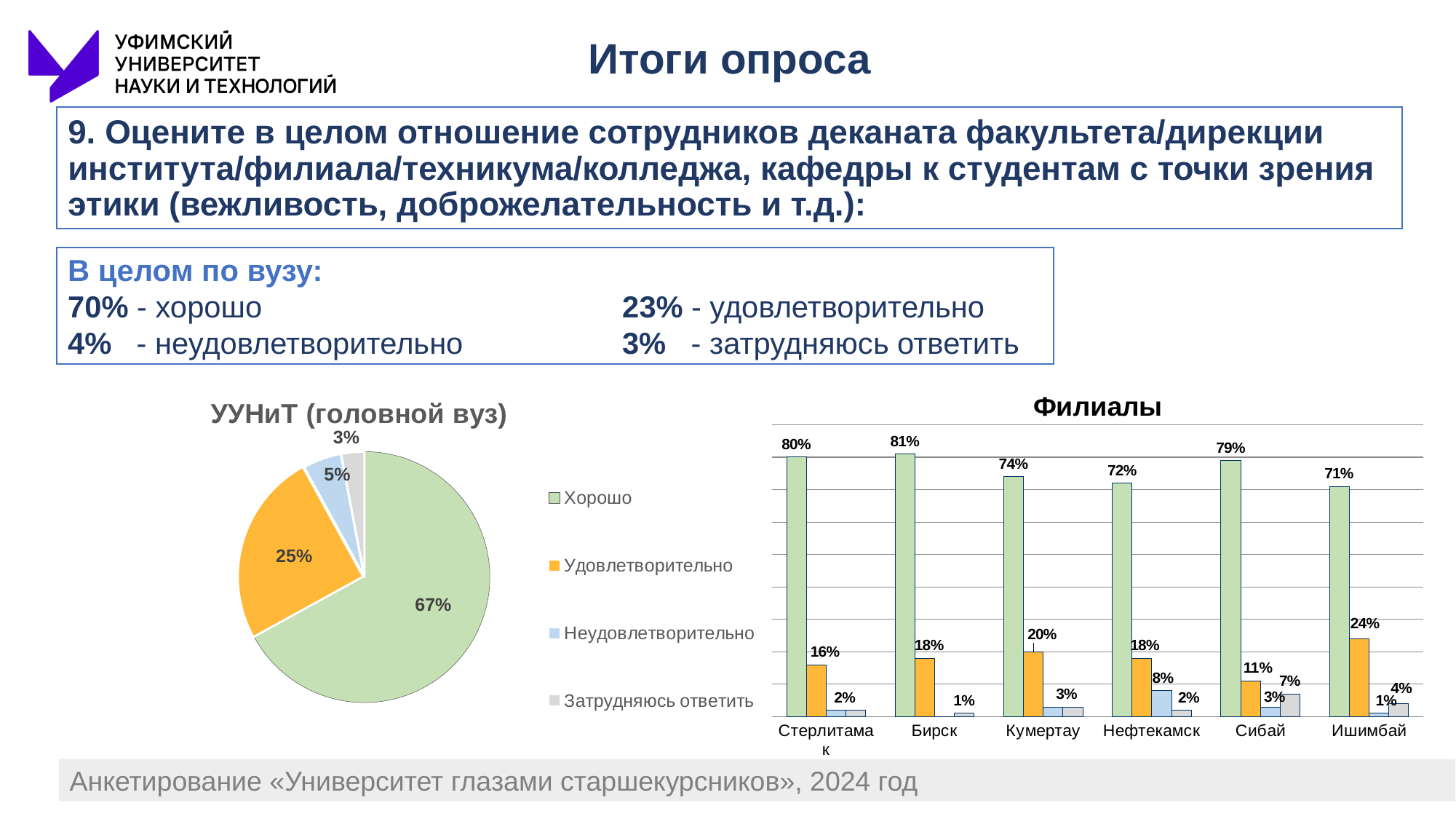
In the 'Филиалы' chart, which branch has the highest 'Хорошо' value? Бирск In the 'Филиалы' chart, what is the 'Хорошо' value for Бирск? 81% In the 'Филиалы' chart, which branch has the lowest 'Хорошо' value? Ишимбай In the 'Филиалы' chart, what is the difference between the 'Хорошо' values for Бирск and Ишимбай? 10 percentage points In the 'УУНиТ (головной вуз)' pie chart, what share does 'Удовлетворительно' have? 25% In the 'Филиалы' chart, what is the 'Неудовлетворительно' value for Нефтекамск? 8% What kind of chart is the 'УУНиТ (головной вуз)' chart? pie chart In the 'Филиалы' chart, what is the 'Удовлетворительно' value for Ишимбай? 24% What kind of chart is the 'Филиалы' chart? bar chart In the 'УУНиТ (головной вуз)' pie chart, what share does 'Хорошо' have? 67% How many branches are shown on the x axis of the 'Филиалы' chart? 6 In the 'УУНиТ (головной вуз)' pie chart, which category has the smallest slice? Затрудняюсь ответить